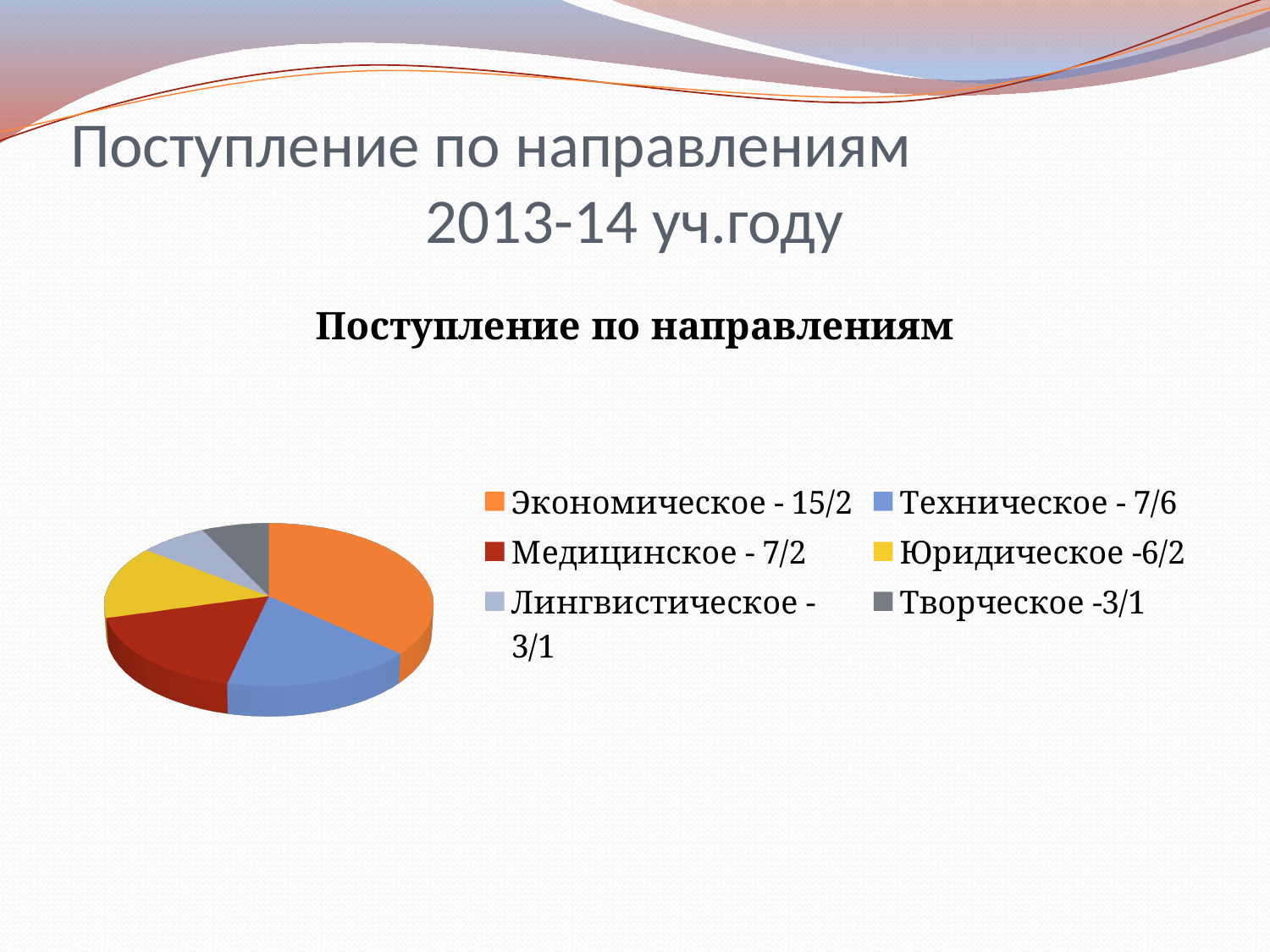
What colour is the slice for Экономическое? orange Which slice is larger, Экономическое or Медицинское? Экономическое Which category has the largest slice of the pie? Экономическое What is the title of the chart? Поступление по направлениям How many categories does the pie chart show? 6 Which slice is larger, Юридическое or Лингвистическое? Юридическое Which slice is larger, Техническое or Творческое? Техническое What kind of chart is shown on the slide? pie chart